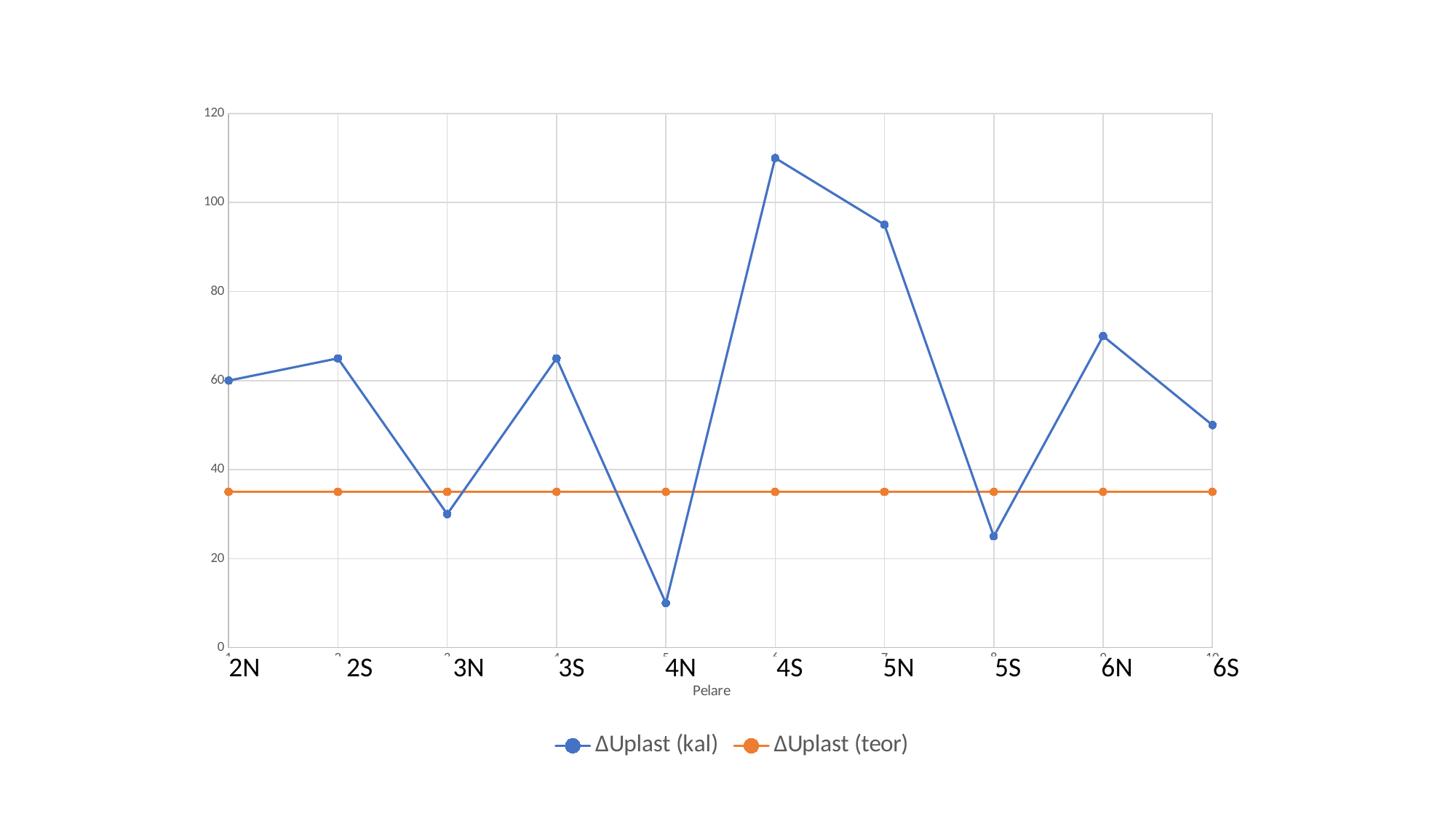
How many categories are plotted along the x axis? 10 Which is larger, the ΔUplast (kal) value for 4S or for 5N? 4S Which is larger, the ΔUplast (kal) value for 6N or for 6S? 6N What kind of chart is shown on the slide? line chart Which category has the lowest value for ΔUplast (kal)? 4N Is the ΔUplast (kal) value for 4N greater or less than 20? less How many series does the legend list? 2 Is the ΔUplast (kal) value for 5S greater or less than 40? less Which category has the highest value for ΔUplast (kal)? 4S What is the title of the x axis? Pelare Is the ΔUplast (kal) value for 6N greater or less than 60? greater